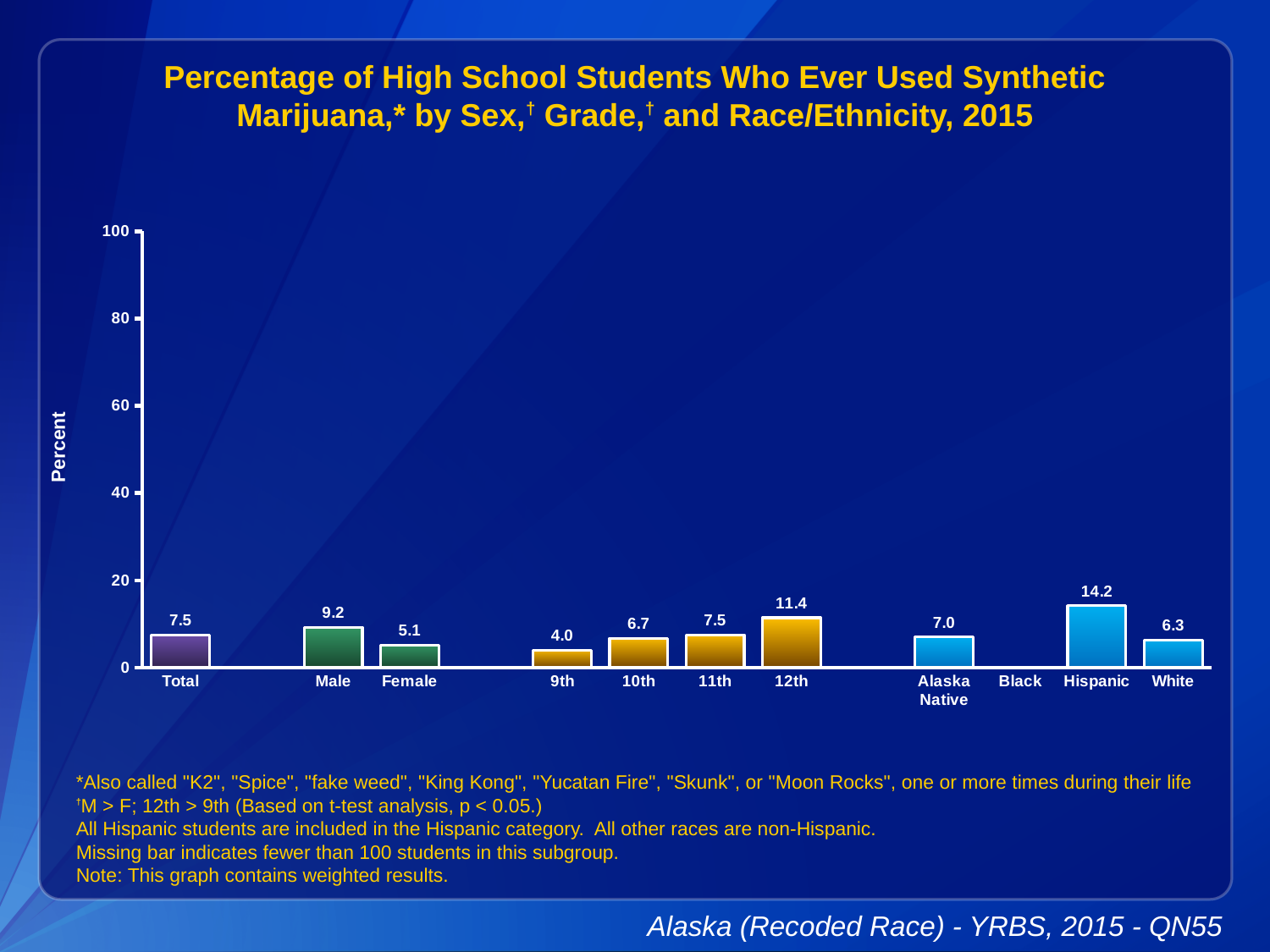
What is the difference between the Male and Female values? 4.1 What is the value for Male? 9.2 Which category with a bar has the lowest value? 9th What is the value for 9th grade? 4.0 What is the value for Total? 7.5 What kind of chart is shown? bar chart Is the value for Hispanic greater or less than 20? less What is the value for Hispanic? 14.2 Which category has the highest value? Hispanic Do the values rise or fall from 9th grade to 12th grade? rise Which category has no bar shown? Black Which is larger, the value for 12th grade or the value for 10th grade? 12th